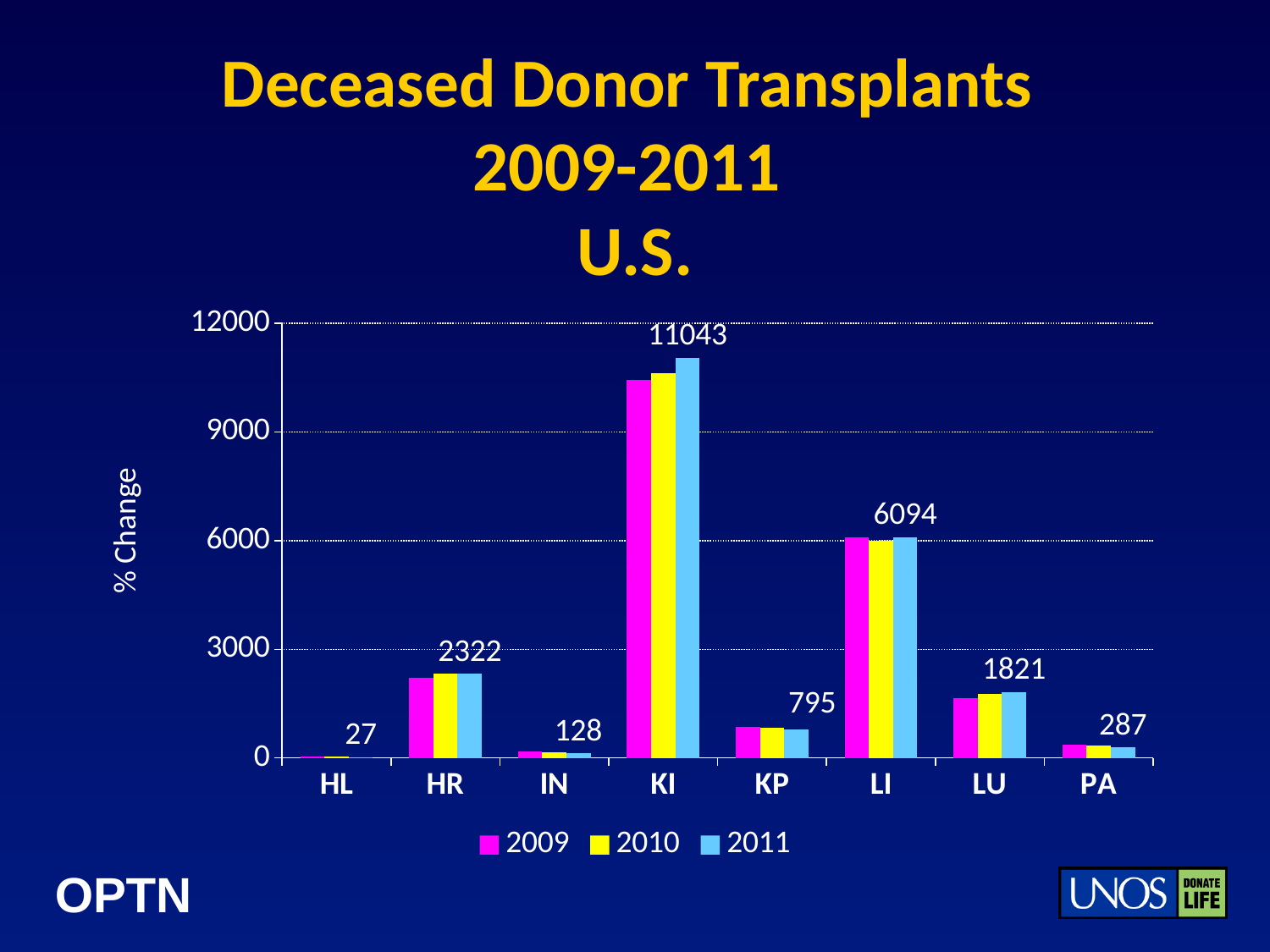
What is the label on the y axis? % Change What is the 2011 value for HL? 27 Which organ category has the lowest number of deceased donor transplants? HL What kind of chart is shown on the slide? bar chart What is the 2011 value for KI? 11043 Which has a larger 2011 value, HR or LU? HR How many organ categories are shown on the x axis? 8 Is the 2009 value for KI greater or less than 9000? greater What is the 2011 value for LI? 6094 Which organ category has the highest number of deceased donor transplants? KI How many series does the legend list? 3 What is the difference between the 2011 values for KI and LI? 4949